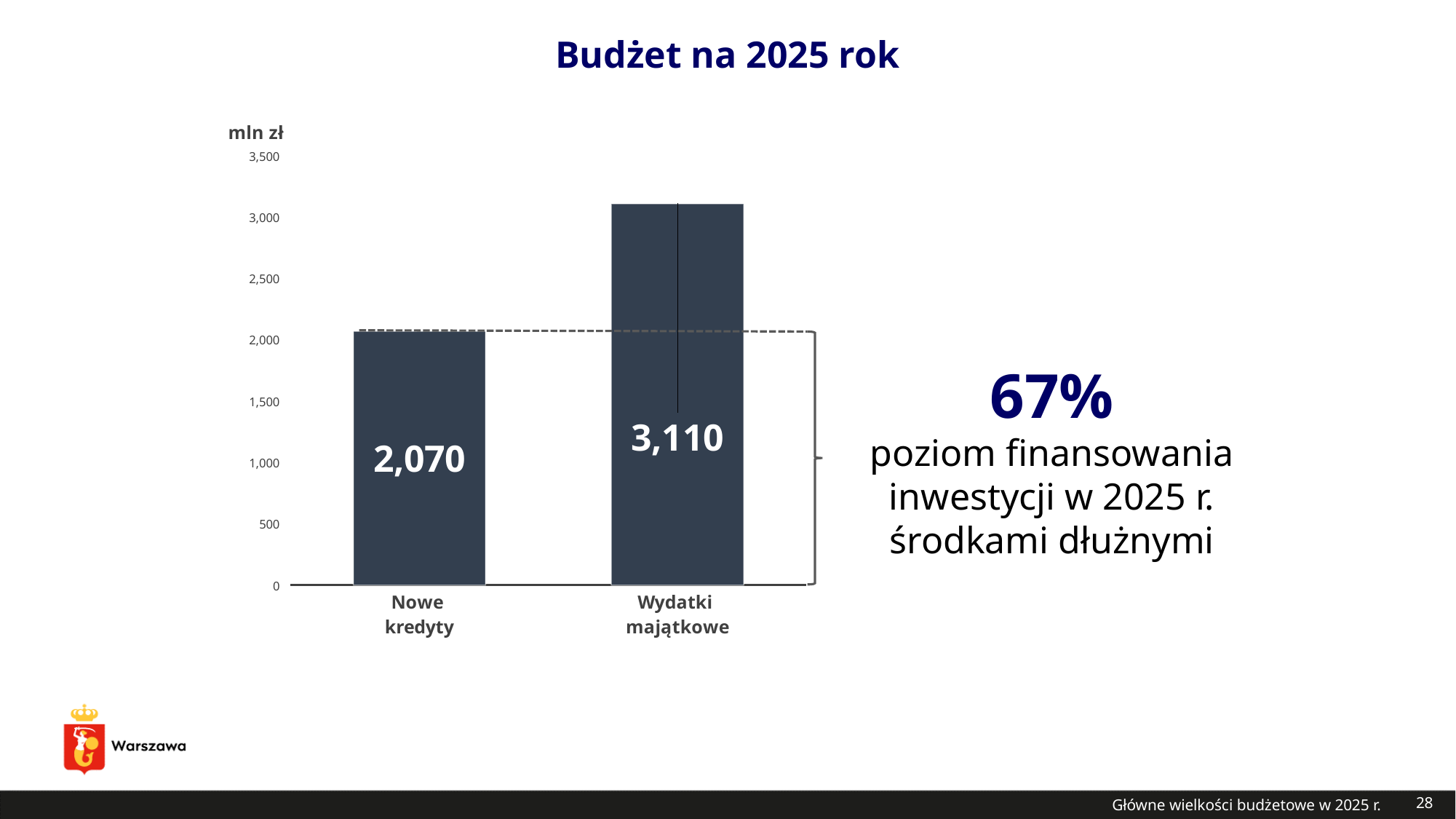
Is the value for Nowe kredyty greater or less than 2,500? less Is the value for Wydatki majątkowe greater or less than 3,000? greater Which category has the highest value? Wydatki majątkowe Which is larger, Nowe kredyty or Wydatki majątkowe? Wydatki majątkowe What is the value for Nowe kredyty? 2,070 What is the title of the slide? Budżet na 2025 rok What kind of chart is shown on the slide? bar chart What is the value for Wydatki majątkowe? 3,110 What unit is shown on the chart's axis? mln zł Which category has the lowest value? Nowe kredyty How many categories are shown on the chart? 2 What is the difference between Wydatki majątkowe and Nowe kredyty? 1,040